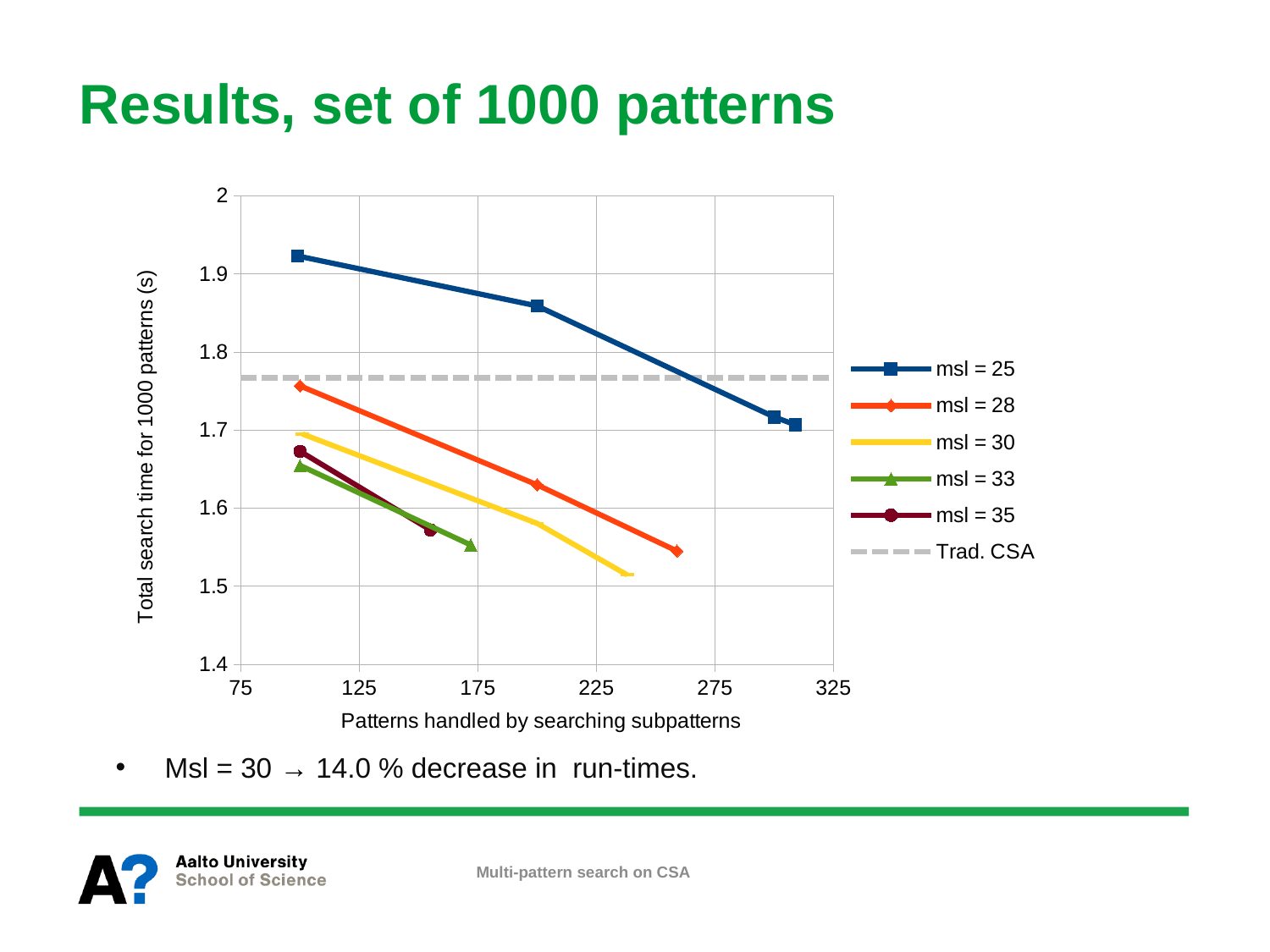
What kind of chart is shown on the slide? line chart Is the first (leftmost) value of the msl = 25 series greater or less than 1.9? greater Is the last (rightmost) value of the msl = 28 series greater or less than 1.6? less How many data points are plotted for the msl = 25 series? 4 What is the label of the y axis? Total search time for 1000 patterns (s) What is the title of the slide containing the chart? Results, set of 1000 patterns Is the last (rightmost) value of the msl = 33 series greater or less than 1.5? greater How many series does the legend list? 6 Which series has the highest total search time values on the chart? msl = 25 Which series has the larger total search time at its leftmost point, msl = 25 or msl = 35? msl = 25 Do the values for the msl = 25 series rise or fall as the number of patterns handled by searching subpatterns increases? fall